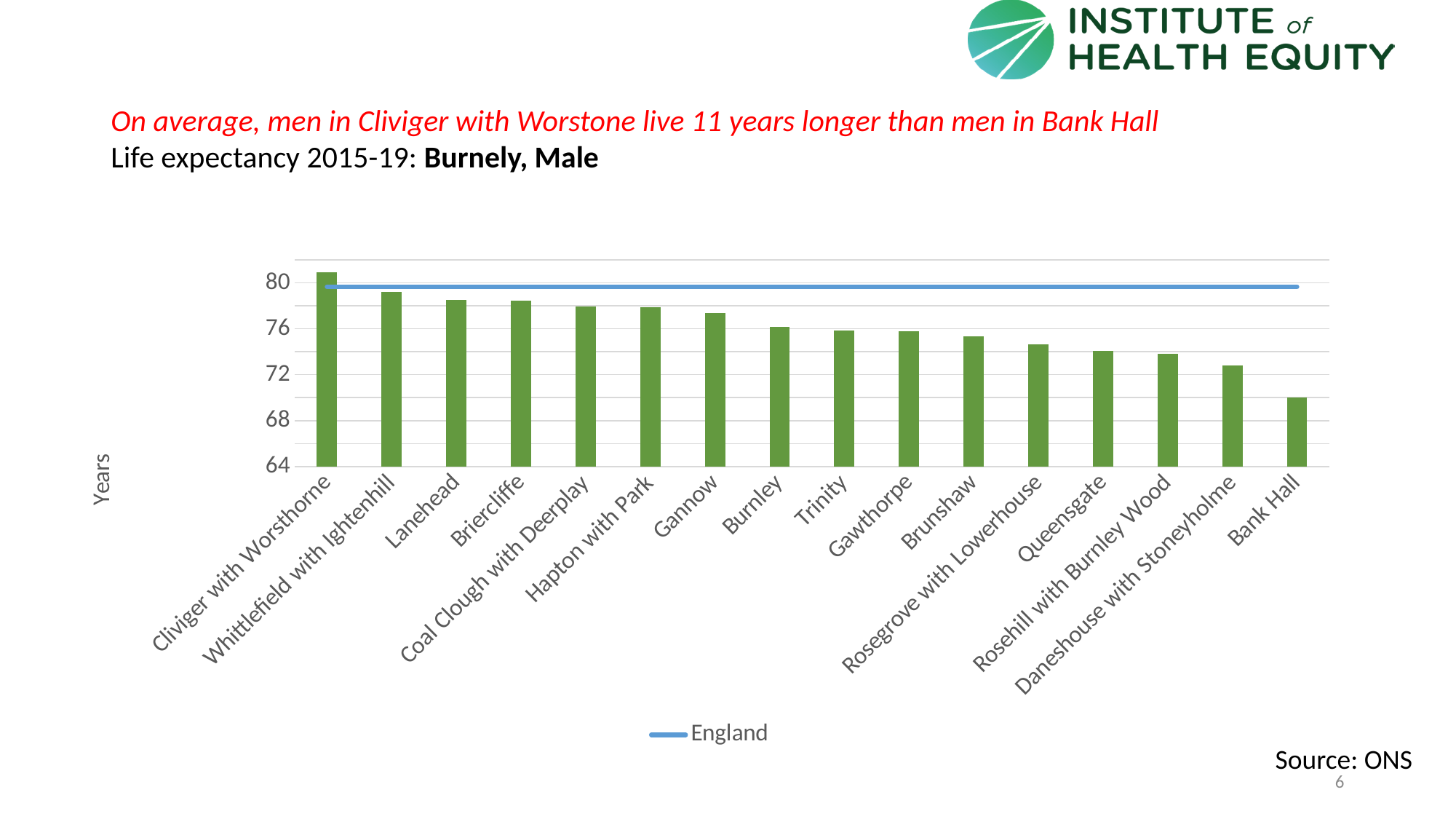
How many entries does the legend list? 1 Do the bar values rise or fall moving from left to right along the x axis? fall What is the label on the vertical axis of the chart? Years Which ward has the highest male life expectancy in the chart? Cliviger with Worsthorne Which has the larger value, Lanehead or Queensgate? Lanehead Is the value for Queensgate greater or less than 76? less What kind of chart is shown on the slide? bar chart Is the value for Gannow greater or less than 76? greater Is the value for Bank Hall greater or less than 72? less Which ward has the lowest male life expectancy in the chart? Bank Hall How many wards (bars) are plotted in the chart? 16